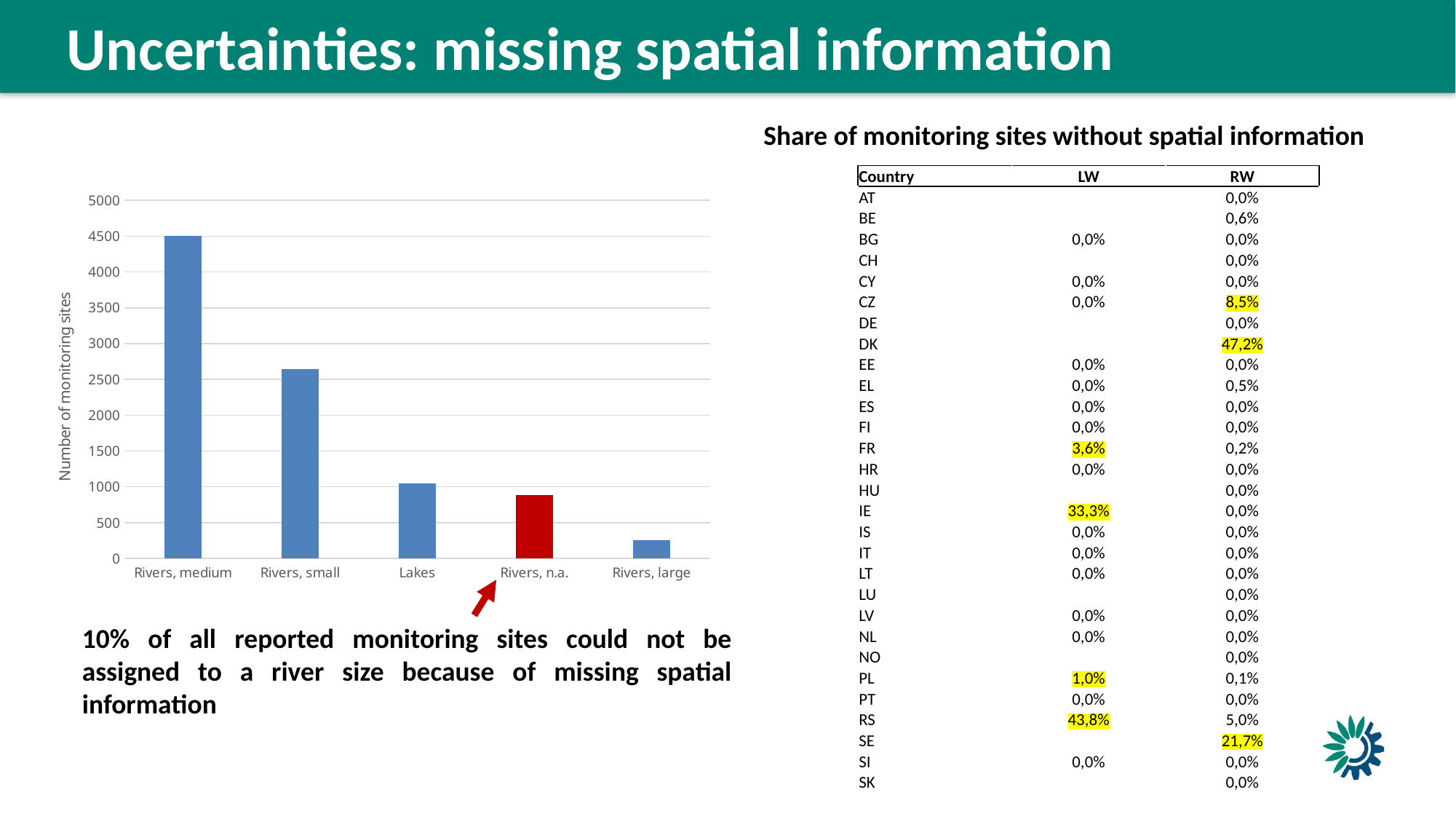
Which category has the lowest number of monitoring sites? Rivers, large Which category has the highest number of monitoring sites? Rivers, medium Is the value for Rivers, n.a. greater or less than 1000? less Is the value for Rivers, small greater or less than 2500? greater What kind of chart is shown on the slide? bar chart Do the bar values generally rise or fall from left to right along the x axis? fall How many categories are shown on the x axis of the bar chart? 5 Which has more monitoring sites, Lakes or Rivers, small? Rivers, small Is the value for Lakes greater or less than 1500? less What is the label of the y axis of the bar chart? Number of monitoring sites Which has more monitoring sites, Rivers, n.a. or Rivers, large? Rivers, n.a.